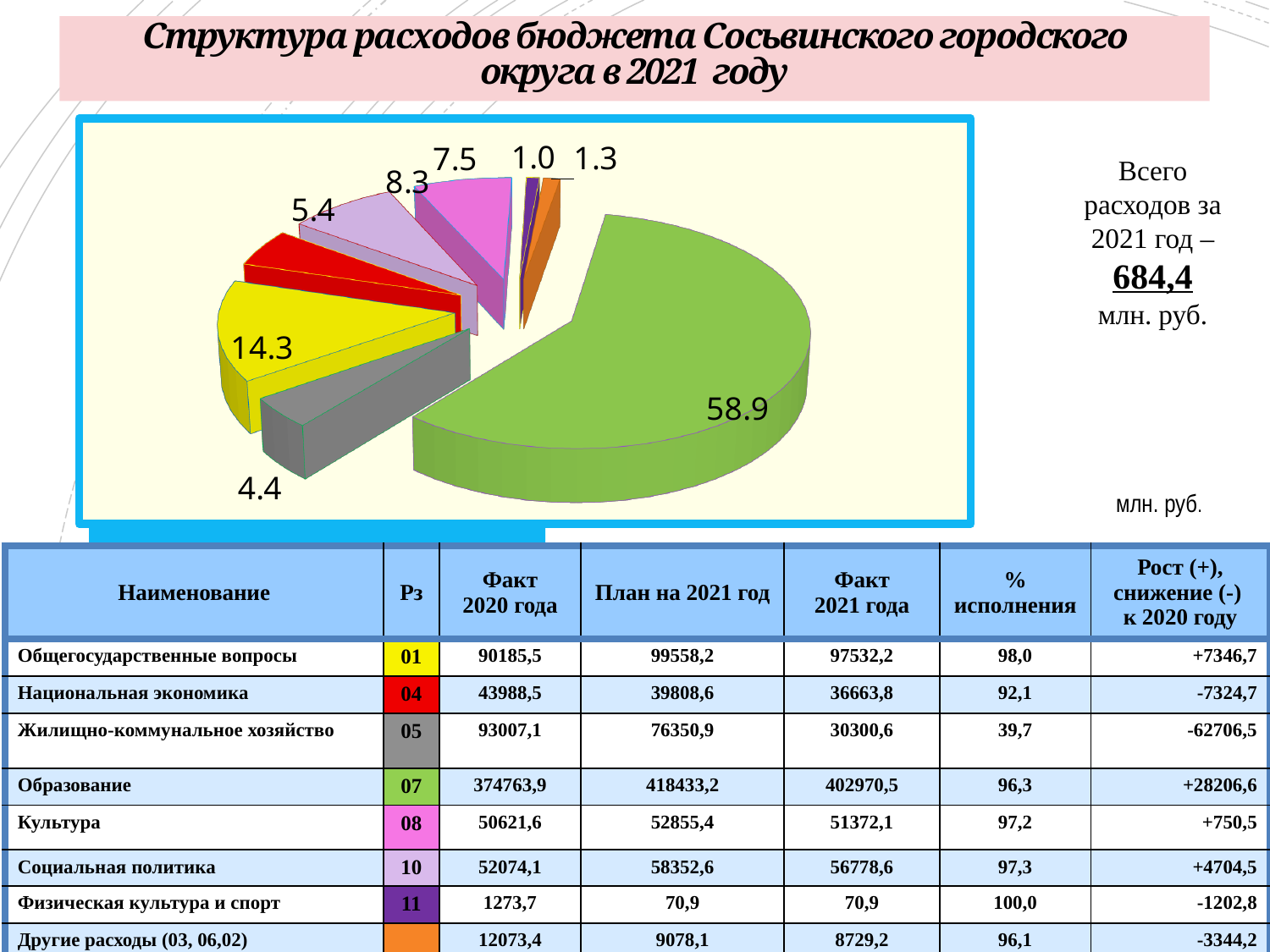
What is the value labelled on the largest (green) slice of the pie chart? 58.9 According to the text next to the pie chart, what were the total expenditures for 2021? 684,4 млн. руб. What kind of chart is shown on the slide? Pie chart Which slice of the pie chart has the smallest labelled value? The dark purple slice (1.0) Which slice of the pie chart has the largest labelled value? The green slice (58.9) How many slices does the pie chart have? 8 What is the value labelled on the grey slice of the pie chart? 4.4 What is the value labelled on the orange slice of the pie chart? 1.3 Which is larger in the pie chart: the yellow slice or the red slice? The yellow slice What is the value labelled on the red slice of the pie chart? 5.4 What is the difference between the largest slice (58.9) and the yellow slice (14.3) in the pie chart? 44.6 What is the value labelled on the yellow slice of the pie chart? 14.3